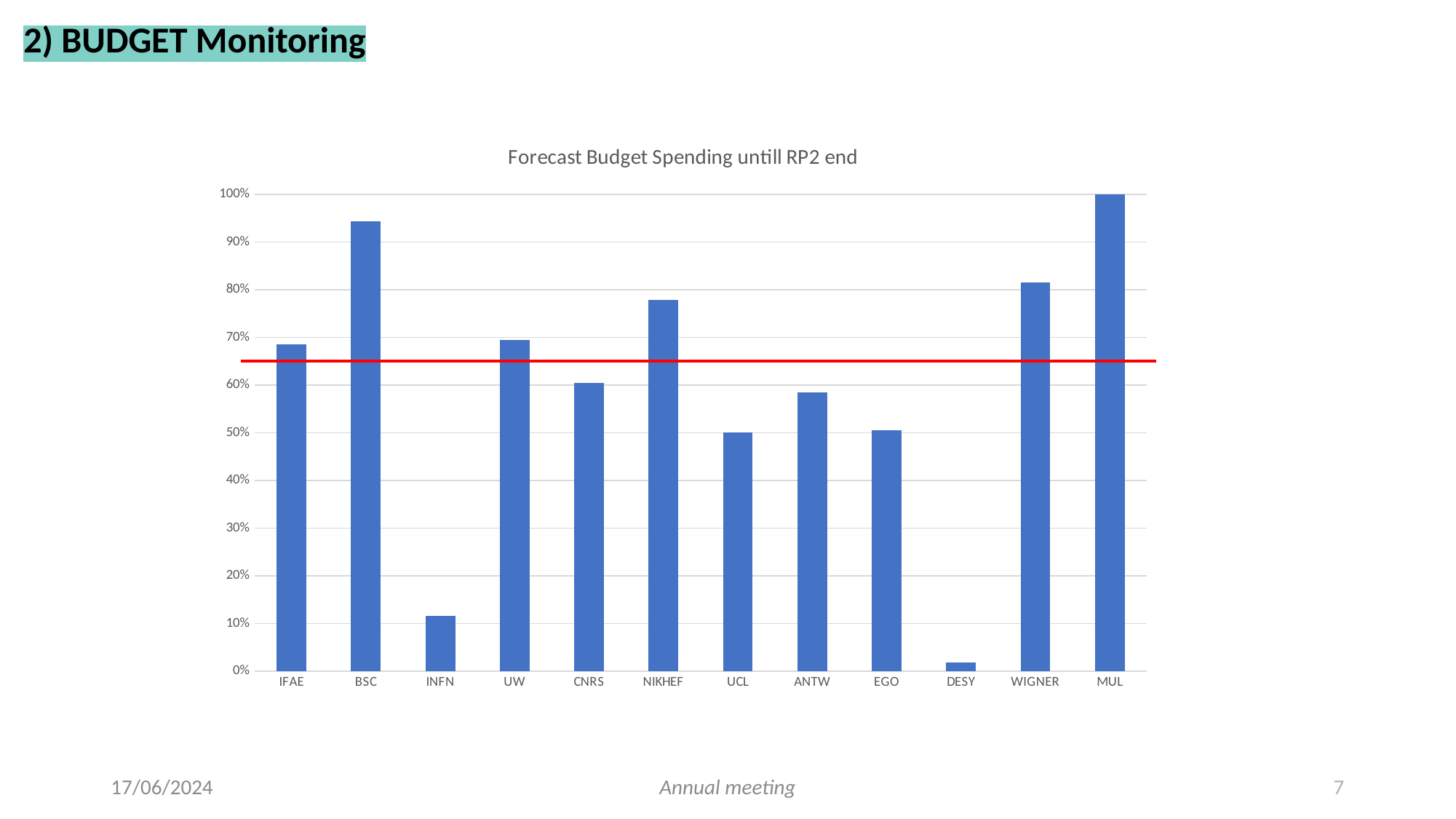
Which is larger, the value for WIGNER or the value for ANTW? WIGNER Which institution has the lowest forecast budget spending? DESY What is the title of the chart? Forecast Budget Spending untill RP2 end Is the value for CNRS greater or less than 70%? less Is the value for INFN greater or less than 20%? less Is the value for BSC greater or less than 90%? greater What colour is the horizontal reference line drawn across the chart? red Which institution has the highest forecast budget spending? MUL How many institutions (categories) are shown on the x axis of the chart? 12 What kind of chart is shown on the slide? bar chart